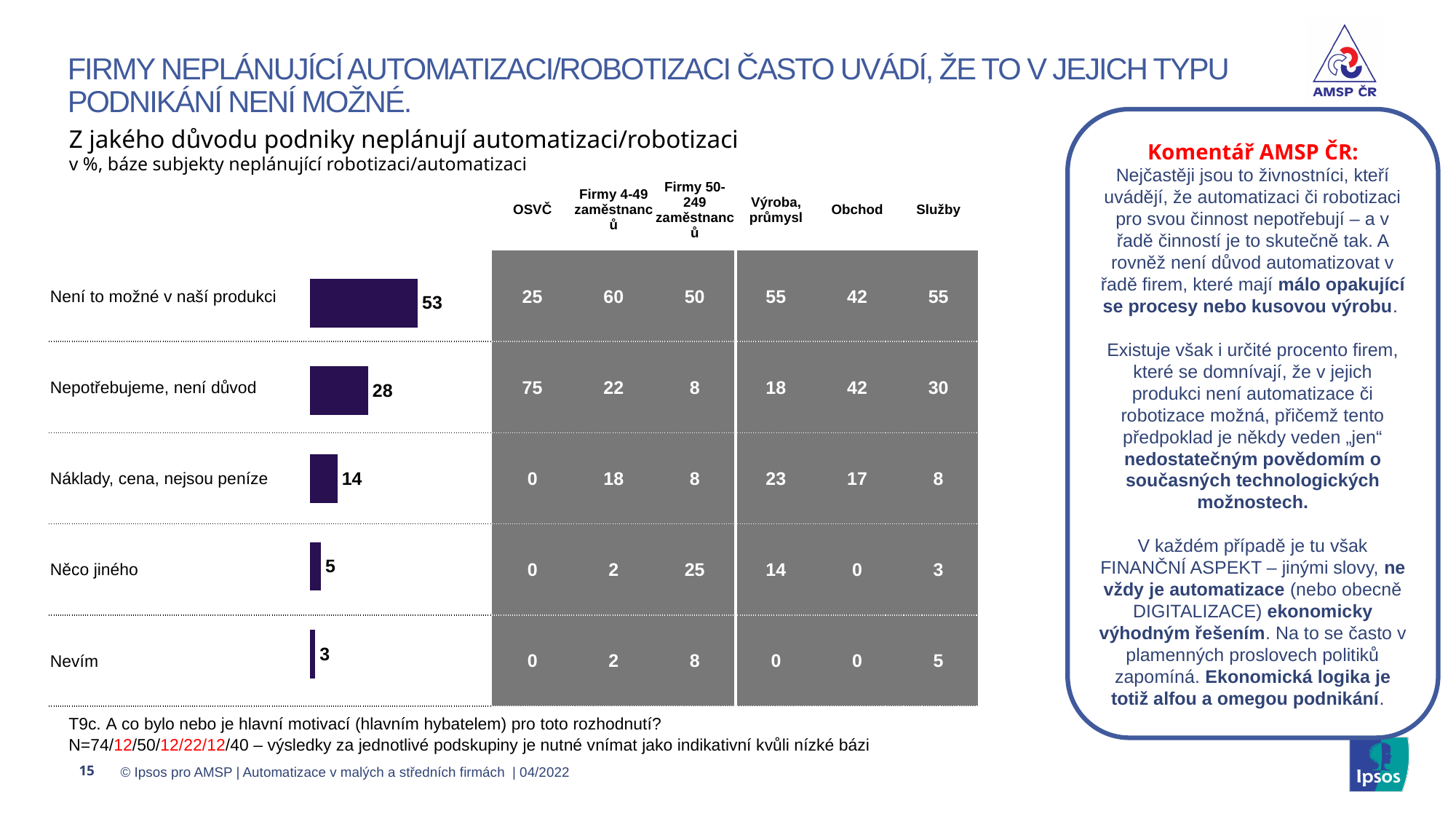
How many categories are shown in the bar chart? 5 What is the title of the chart? Z jakého důvodu podniky neplánují automatizaci/robotizaci What is the value for "Náklady, cena, nejsou peníze" in the bar chart? 14 What is the value for "Není to možné v naší produkci" in the bar chart? 53 Which category has the highest value in the bar chart? Není to možné v naší produkci What is the difference between the values for "Něco jiného" and "Nevím" in the bar chart? 2 What is the value for "Nepotřebujeme, není důvod" in the bar chart? 28 What is the difference between the values for "Není to možné v naší produkci" and "Nepotřebujeme, není důvod"? 25 What is the value for "Nevím" in the bar chart? 3 Which category has the lowest value in the bar chart? Nevím What kind of chart is shown on the slide? Bar chart Which is larger in the bar chart: "Náklady, cena, nejsou peníze" or "Něco jiného"? Náklady, cena, nejsou peníze